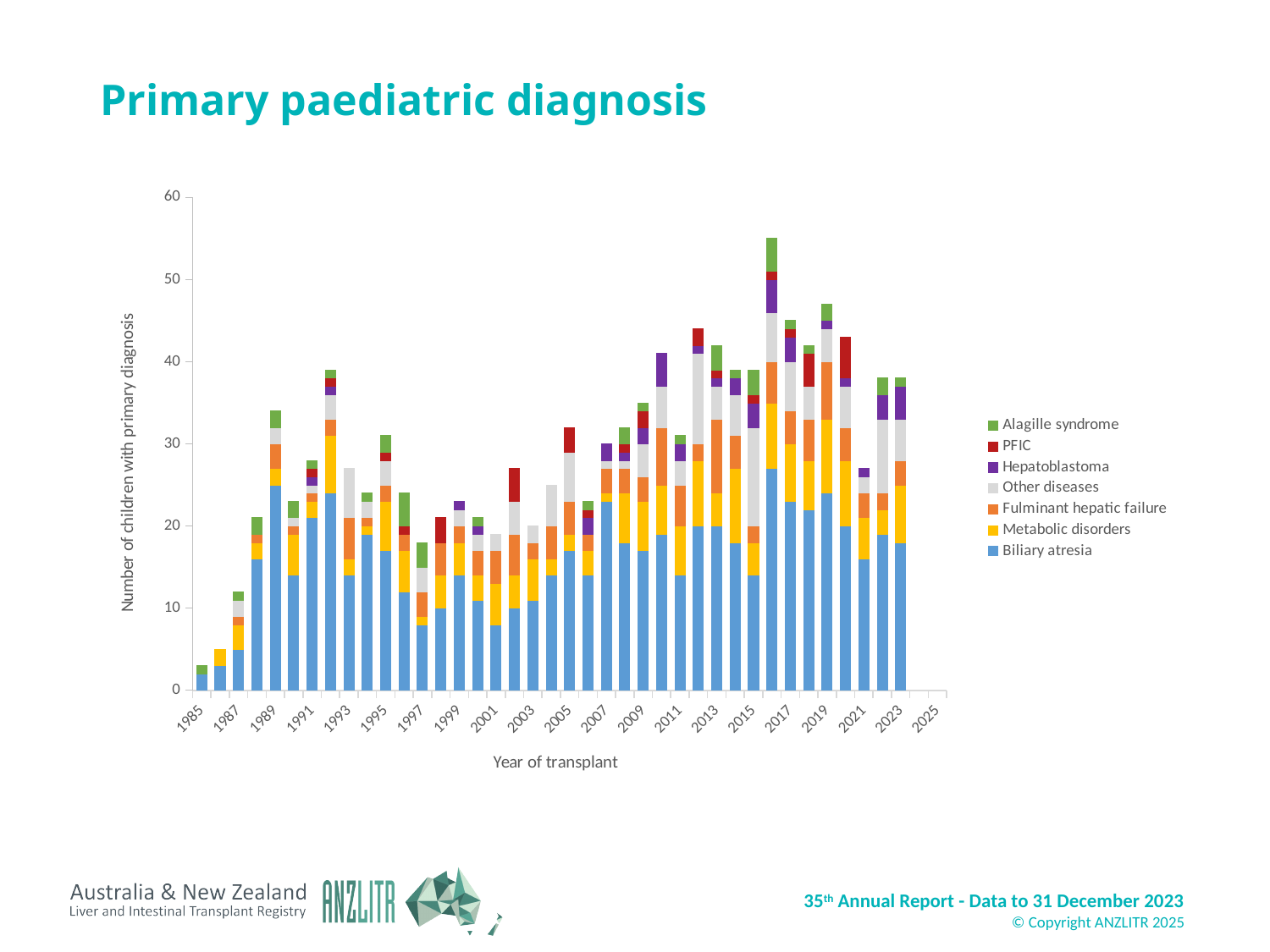
Is the total number of children for 1985 greater or less than 10? less Which year has a higher total, 2016 or 2019? 2016 Which year has the shortest stacked bar? 1985 What kind of chart is shown on the slide? Stacked bar chart Is the total number of children for 2016 greater or less than 50? greater Which year has the tallest stacked bar? 2016 Which year has a higher total, 1992 or 1993? 1992 What is the label of the vertical axis? Number of children with primary diagnosis What is the title of the chart? Primary paediatric diagnosis Is the total number of children for 2021 greater or less than 30? less How many series does the legend list? 7